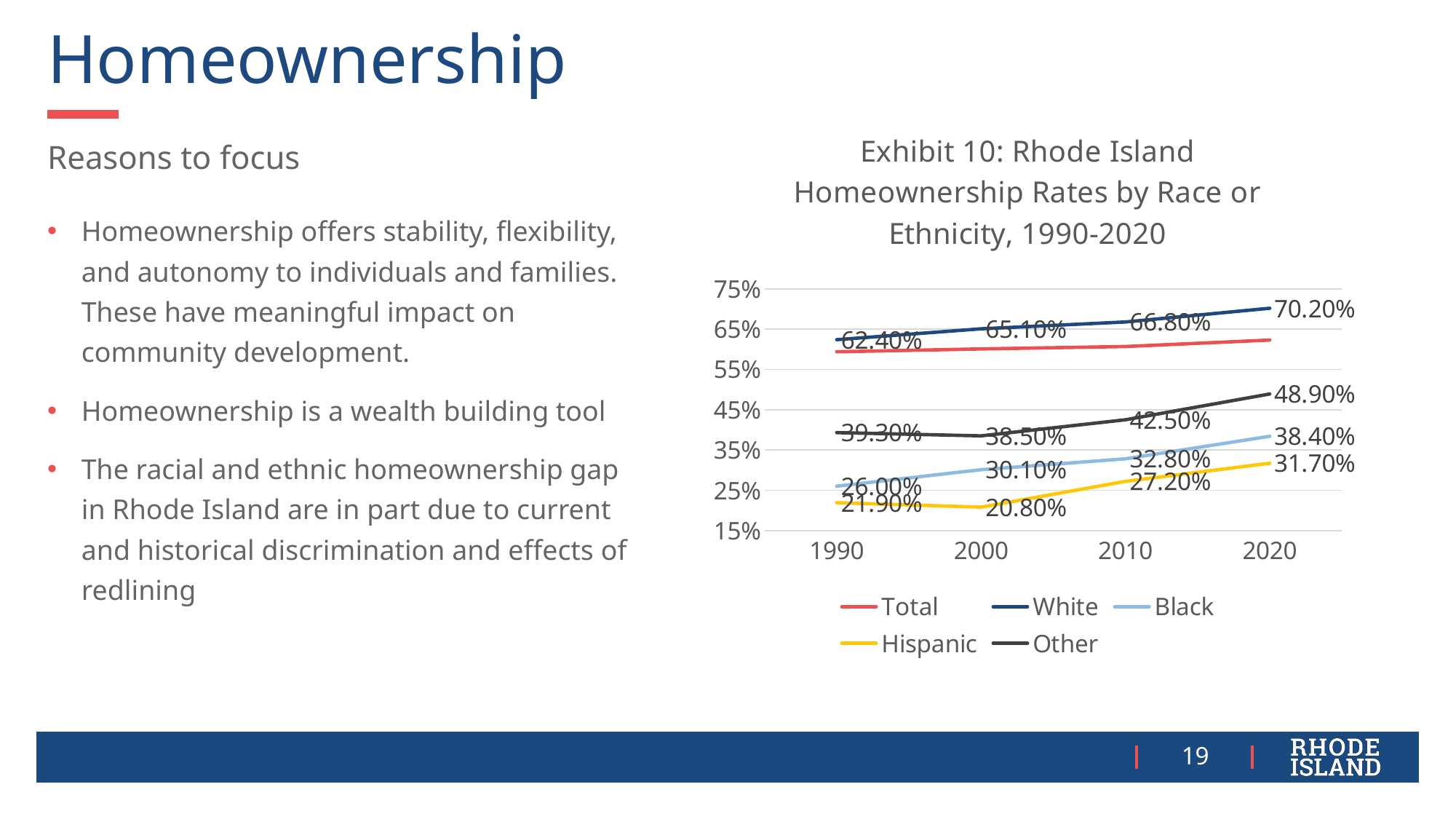
Which is larger in 2010: the homeownership rate for Black households or for Hispanic households? Black What is the homeownership rate for White households in 2020? 70.20% How many series does the legend list? 5 What is the homeownership rate for Black households in 2010? 32.80% Which group has the highest homeownership rate in 2020? White What is the homeownership rate for Hispanic households in 2000? 20.80% How many years are shown on the x axis? 4 What kind of chart is Exhibit 10? line chart What is the difference between the White and Black homeownership rates in 2020? 31.80% Is the Total homeownership rate in 1990 greater or less than 65%? less Which group has the lowest homeownership rate in 1990? Hispanic What is the homeownership rate for the Other group in 1990? 39.30%